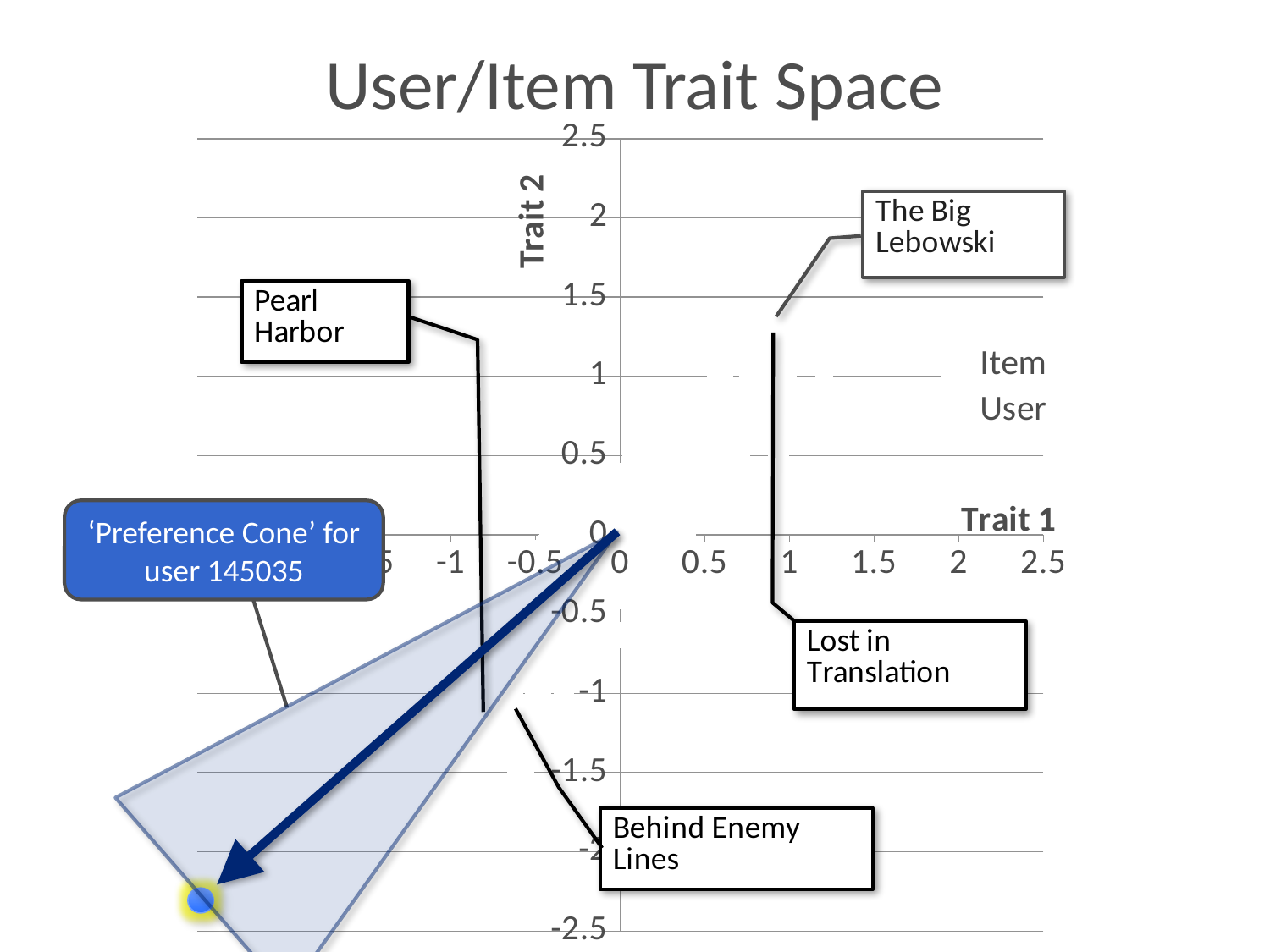
Is the Trait 2 value of the highlighted user point greater or less than -2? less How many series does the chart legend list? 2 Which labelled movie is positioned in the upper-right region of the chart? The Big Lebowski How many movies are labelled with callouts on the chart? 4 Which user is the 'Preference Cone' drawn for? User 145035 Is the Trait 1 value of the highlighted user point greater or less than -2? less What is the title of the chart? User/Item Trait Space What kind of chart is shown on the slide? Scatter chart What are the two entries in the chart legend? Item and User